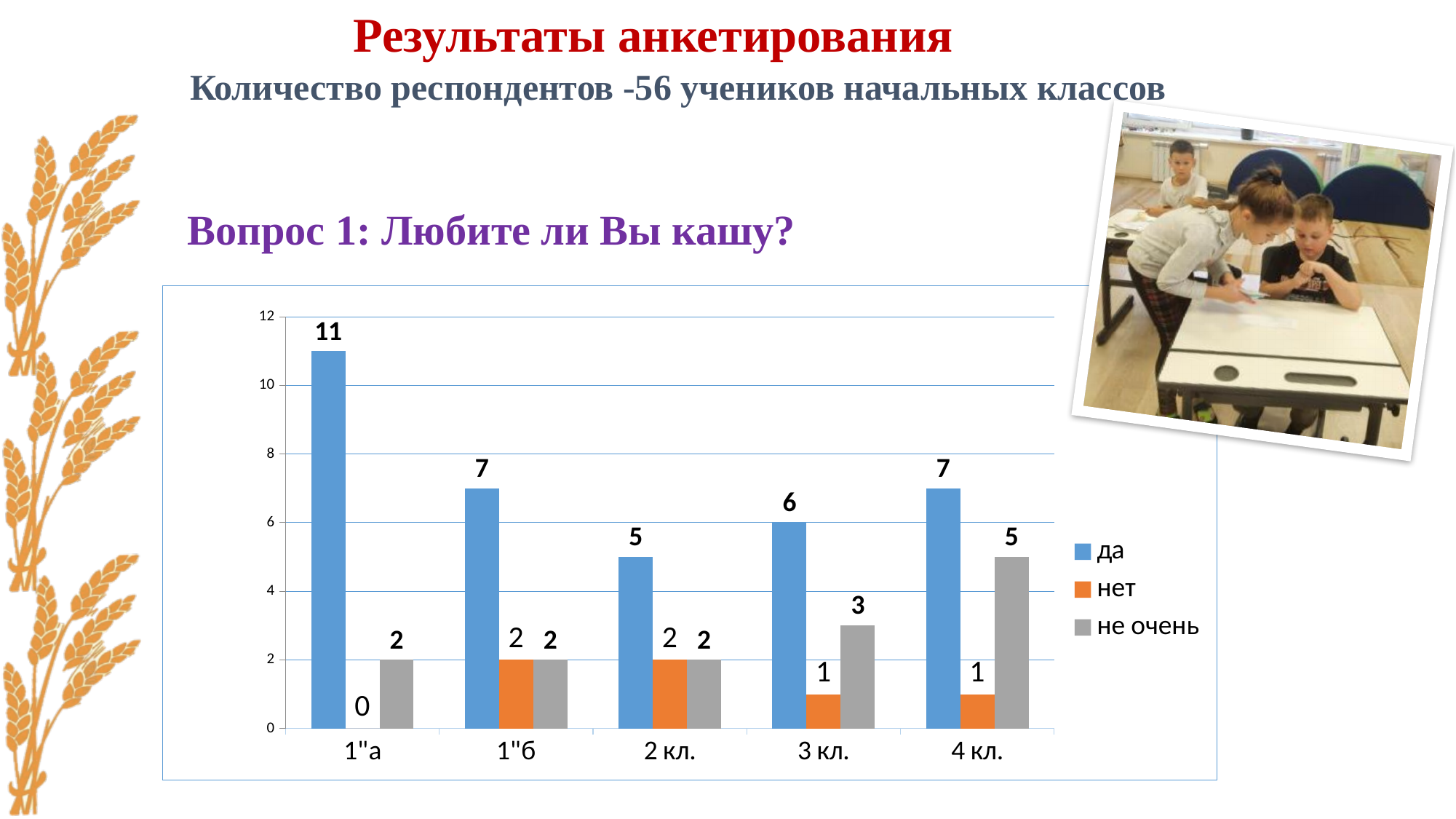
What is the value for "нет" in the 1"а category? 0 What kind of chart is shown on the slide? bar chart What is the value for "не очень" in the 4 кл. category? 5 What is the difference between the "да" values for 1"а and 1"б? 4 What colour represents the "нет" series in the legend? orange How many series does the legend list? 3 Is the value for "да" in 3 кл. greater or less than 4? greater How many categories are shown on the x axis? 5 Which category has the lowest value for "да"? 2 кл. What is the value for "да" in the 1"а category? 11 Which category has the highest value for "да"? 1"а Which is larger: "не очень" for 3 кл. or "не очень" for 4 кл.? 4 кл.